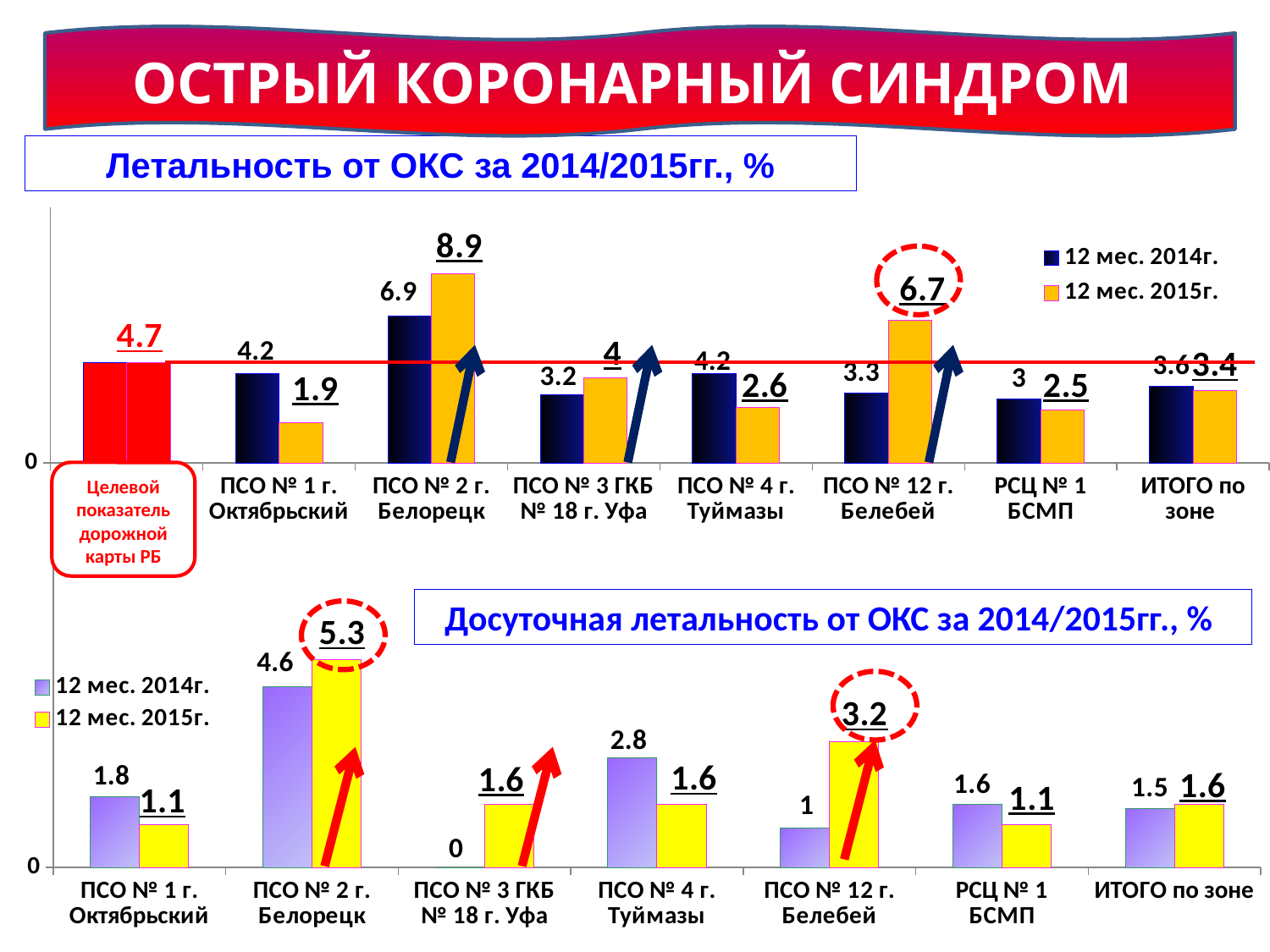
In the chart 'Летальность от ОКС за 2014/2015гг., %', which category has the lowest value for 12 мес. 2015г.? ПСО № 1 г. Октябрьский In the chart 'Летальность от ОКС за 2014/2015гг., %', what is the value for ПСО № 12 г. Белебей for 12 мес. 2014г.? 3.3 In the chart 'Летальность от ОКС за 2014/2015гг., %', which category has the highest value for 12 мес. 2015г.? ПСО № 2 г. Белорецк In the chart 'Летальность от ОКС за 2014/2015гг., %', what is the value for ПСО № 2 г. Белорецк for 12 мес. 2015г.? 8.9 What type of chart is 'Летальность от ОКС за 2014/2015гг., %'? Bar chart In the chart 'Досуточная летальность от ОКС за 2014/2015гг., %', what is the difference between the 12 мес. 2015г. and 12 мес. 2014г. values for ПСО № 12 г. Белебей? 2.2 In the chart 'Досуточная летальность от ОКС за 2014/2015гг., %', what is the value for ПСО № 2 г. Белорецк for 12 мес. 2015г.? 5.3 In the chart 'Летальность от ОКС за 2014/2015гг., %', what is the difference between the 12 мес. 2015г. and 12 мес. 2014г. values for ПСО № 12 г. Белебей? 3.4 How many series does the legend list in the chart 'Досуточная летальность от ОКС за 2014/2015гг., %'? 2 In the chart 'Досуточная летальность от ОКС за 2014/2015гг., %', which is larger for ПСО № 4 г. Туймазы: the 12 мес. 2014г. value or the 12 мес. 2015г. value? 12 мес. 2014г. In the chart 'Досуточная летальность от ОКС за 2014/2015гг., %', what is the value for ПСО № 3 ГКБ № 18 г. Уфа for 12 мес. 2014г.? 0 In the chart 'Летальность от ОКС за 2014/2015гг., %', what is the target value (Целевой показатель дорожной карты РБ) shown by the red bar? 4.7